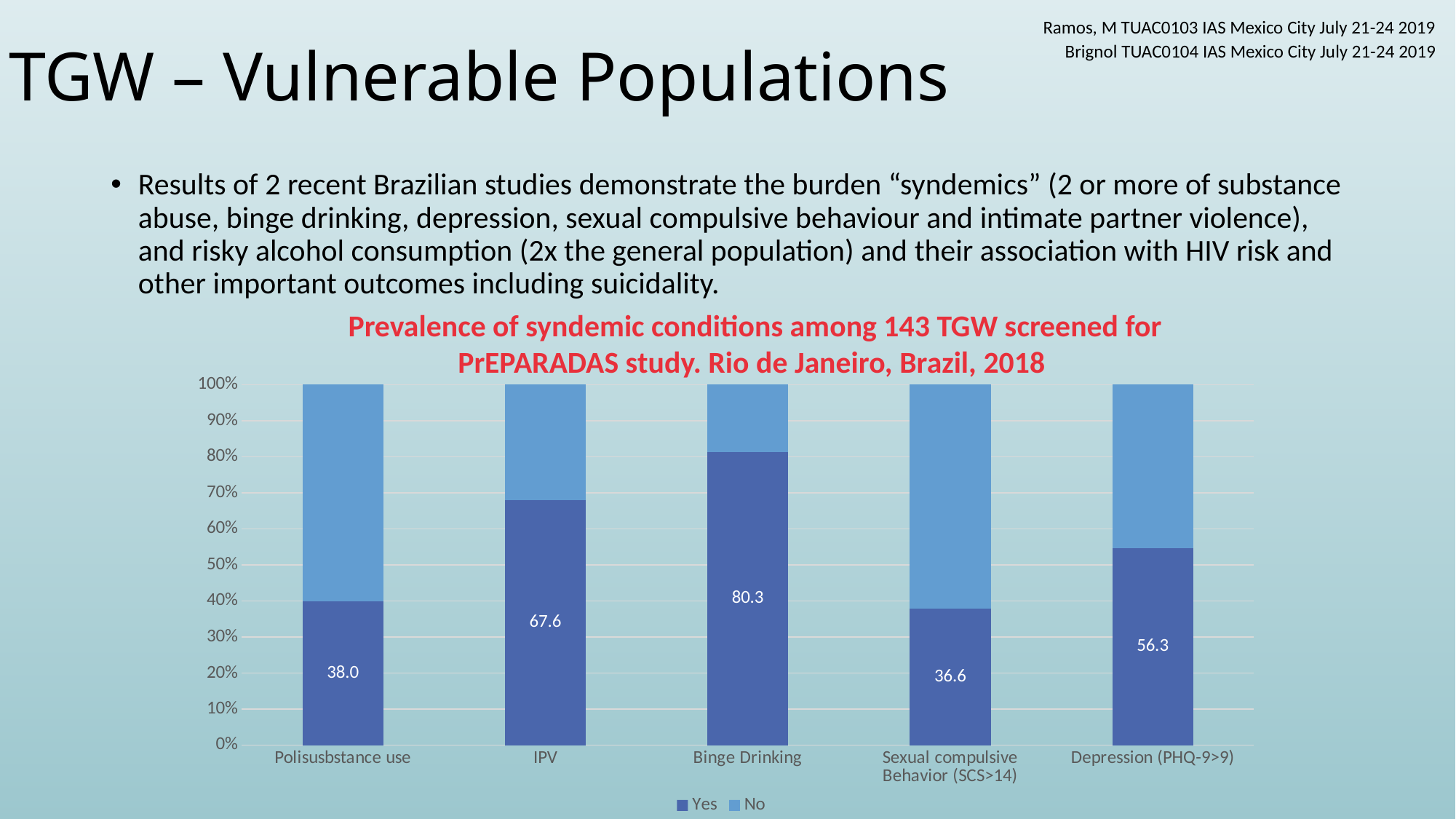
Which condition has the lowest 'Yes' value? Sexual compulsive Behavior (SCS>14) What is the difference between the 'Yes' values for Binge Drinking and Polisusbstance use? 42.3 How many syndemic conditions are shown on the x axis? 5 Which condition has the highest 'Yes' value? Binge Drinking Is the 'No' share for Binge Drinking greater or less than 30%? less What is the 'Yes' value for Depression (PHQ-9>9)? 56.3 How many series does the legend list? 2 What is the 'Yes' value for Binge Drinking? 80.3 What is the 'Yes' value for Polisusbstance use? 38.0 What kind of chart is shown on the slide? Stacked bar chart What is the 'Yes' value for IPV? 67.6 Which has a larger 'Yes' value, IPV or Depression (PHQ-9>9)? IPV